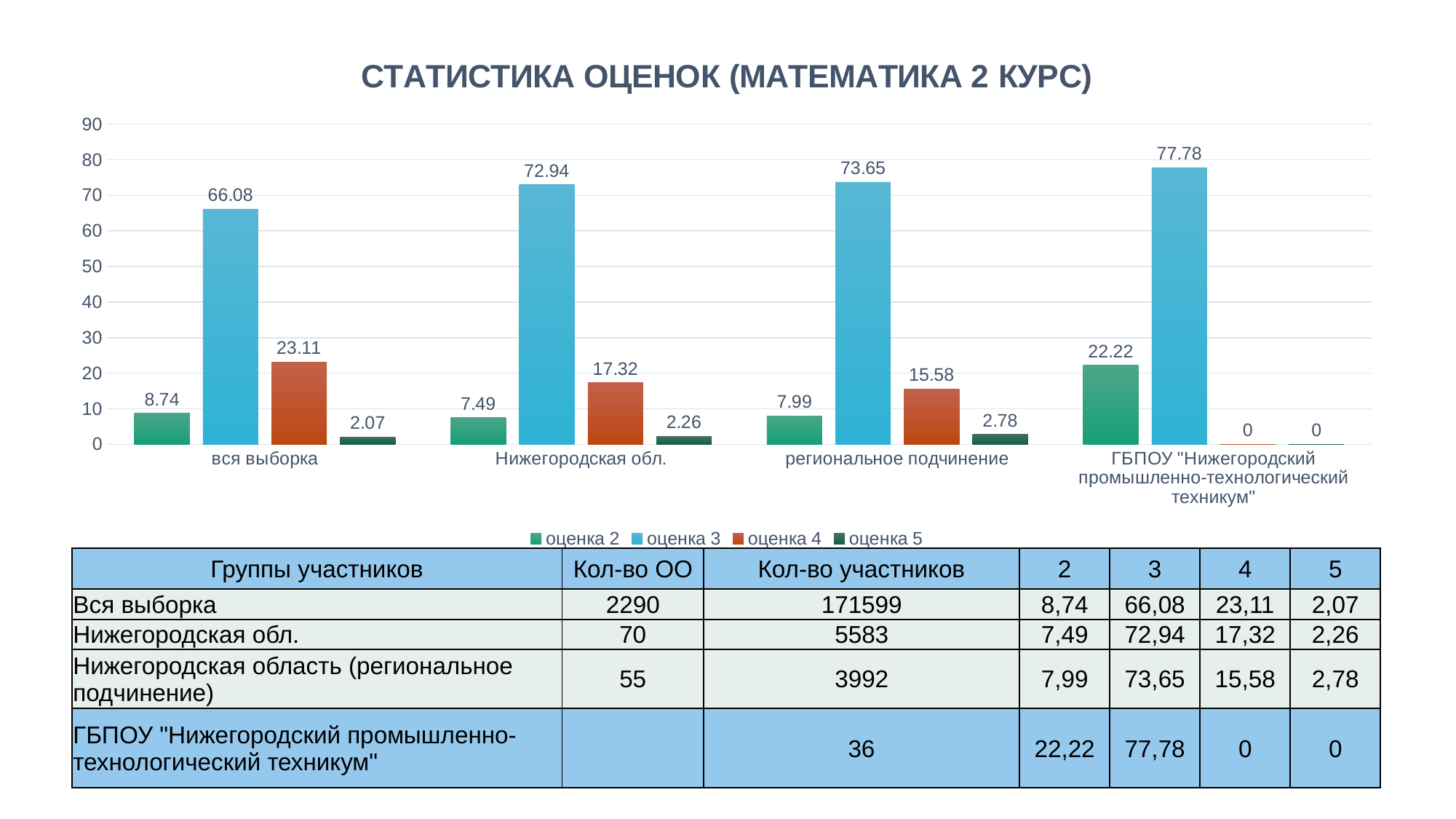
What is the value of оценка 2 for ГБПОУ "Нижегородский промышленно-технологический техникум"? 22.22 What is the value of оценка 5 for региональное подчинение? 2.78 What is the value of оценка 4 for Нижегородская обл.? 17.32 What is the value of оценка 3 for вся выборка? 66.08 Is the value of оценка 3 for региональное подчинение greater or less than 70? greater What kind of chart is shown on the slide? bar chart Which category has the highest value for оценка 3? ГБПОУ "Нижегородский промышленно-технологический техникум" Which category has the lowest value for оценка 4? ГБПОУ "Нижегородский промышленно-технологический техникум" What is the difference between оценка 3 for Нижегородская обл. and оценка 3 for вся выборка? 6.86 Which is larger: оценка 2 for вся выборка or оценка 2 for региональное подчинение? вся выборка How many categories are shown on the x axis? 4 How many series does the legend list? 4